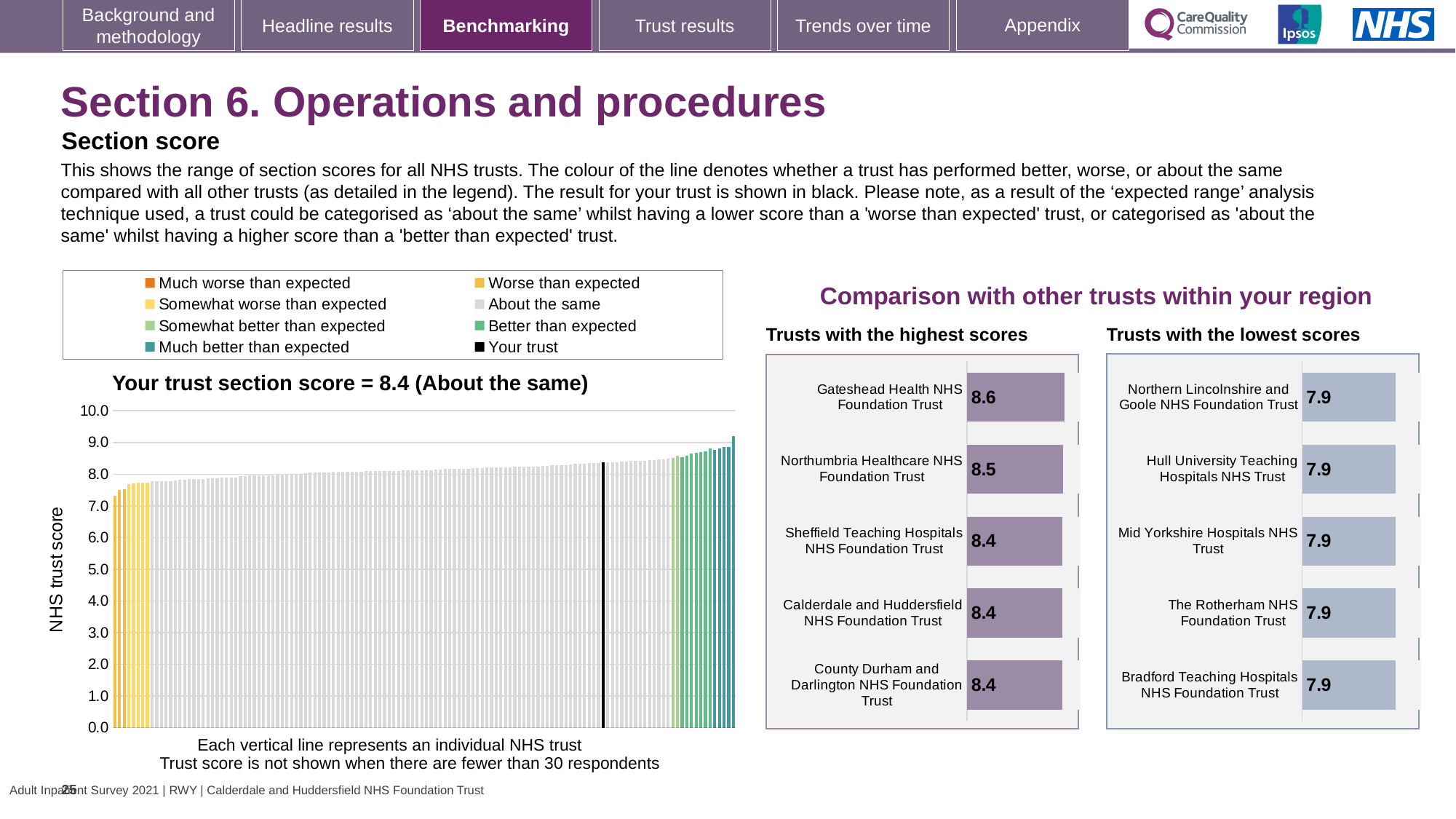
What is the y-axis label of the 'Your trust section score' chart? NHS trust score In the 'Trusts with the lowest scores' chart, what is the score for Hull University Teaching Hospitals NHS Trust? 7.9 How many trusts are shown in the 'Trusts with the lowest scores' chart? 5 In the 'Trusts with the highest scores' chart, what is the difference between the scores of Gateshead Health NHS Foundation Trust and Northumbria Healthcare NHS Foundation Trust? 0.1 In the 'Your trust section score' chart, is the value of the lowest bar greater or less than 8.0? less In the 'Your trust section score' chart, is the value of the highest bar greater or less than 9.0? greater In the 'Trusts with the highest scores' chart, which trust has the highest score? Gateshead Health NHS Foundation Trust In the 'Trusts with the highest scores' chart, what is the score for Northumbria Healthcare NHS Foundation Trust? 8.5 How many entries does the legend above the 'Your trust section score' chart list? 8 In the 'Your trust section score' chart, what is the section score for your trust? 8.4 In the 'Your trust section score' chart, do the bar values rise or fall from left to right along the x axis? rise What kind of chart is the 'Your trust section score' chart on the left of the slide? bar chart